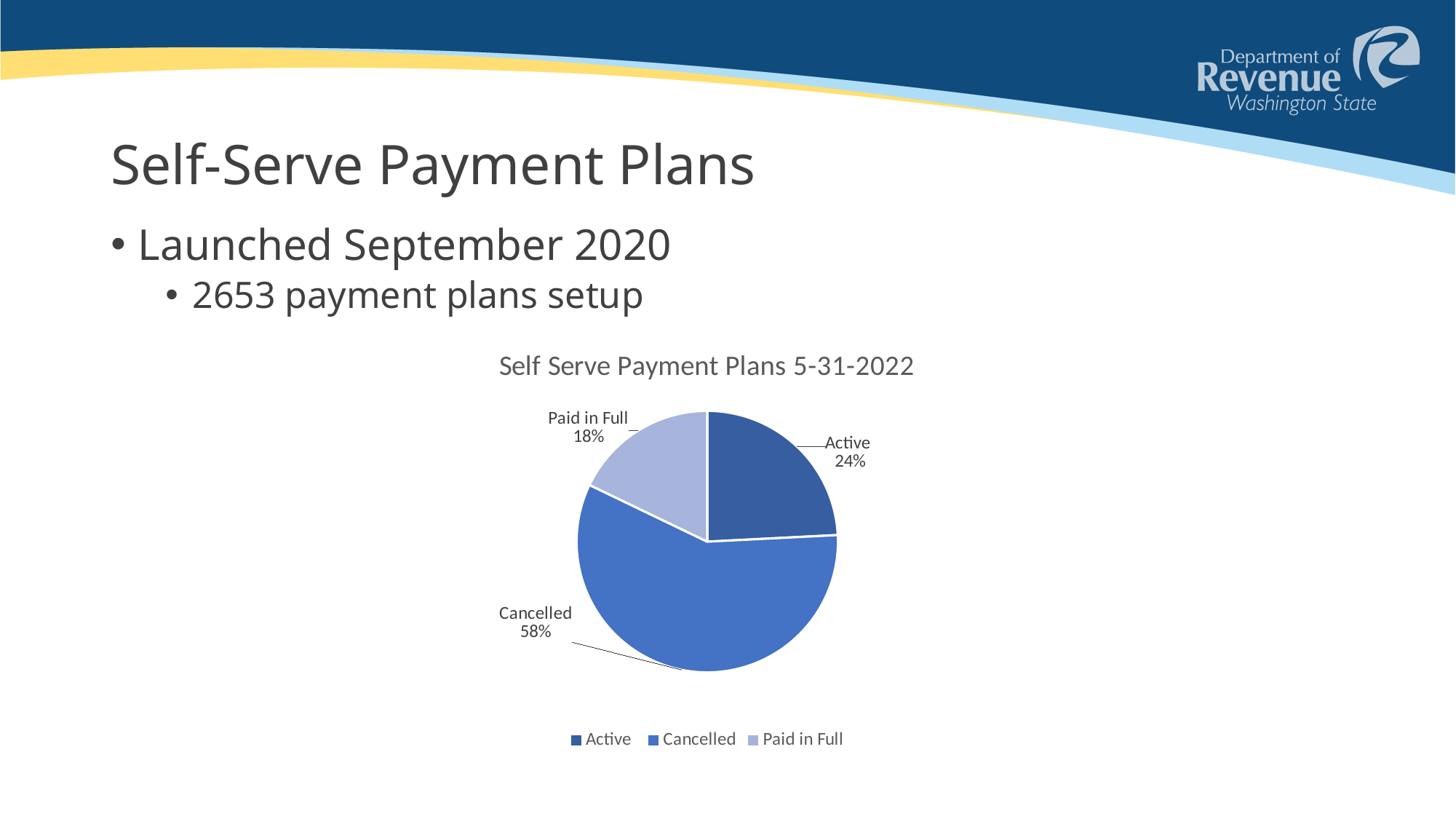
Which category has the largest slice of the pie? Cancelled What share of the pie is Paid in Full? 18% Which is larger, the Active slice or the Paid in Full slice? Active How many slices does the pie chart have? 3 What kind of chart is shown on the slide? pie chart What is the title of the chart? Self Serve Payment Plans 5-31-2022 What is the difference in percentage points between the Cancelled and Active slices? 34 What share of the pie is Active? 24% Is the share for Cancelled greater or less than 50%? greater Which category has the smallest slice of the pie? Paid in Full How many entries does the legend list? 3 What share of the pie is Cancelled? 58%